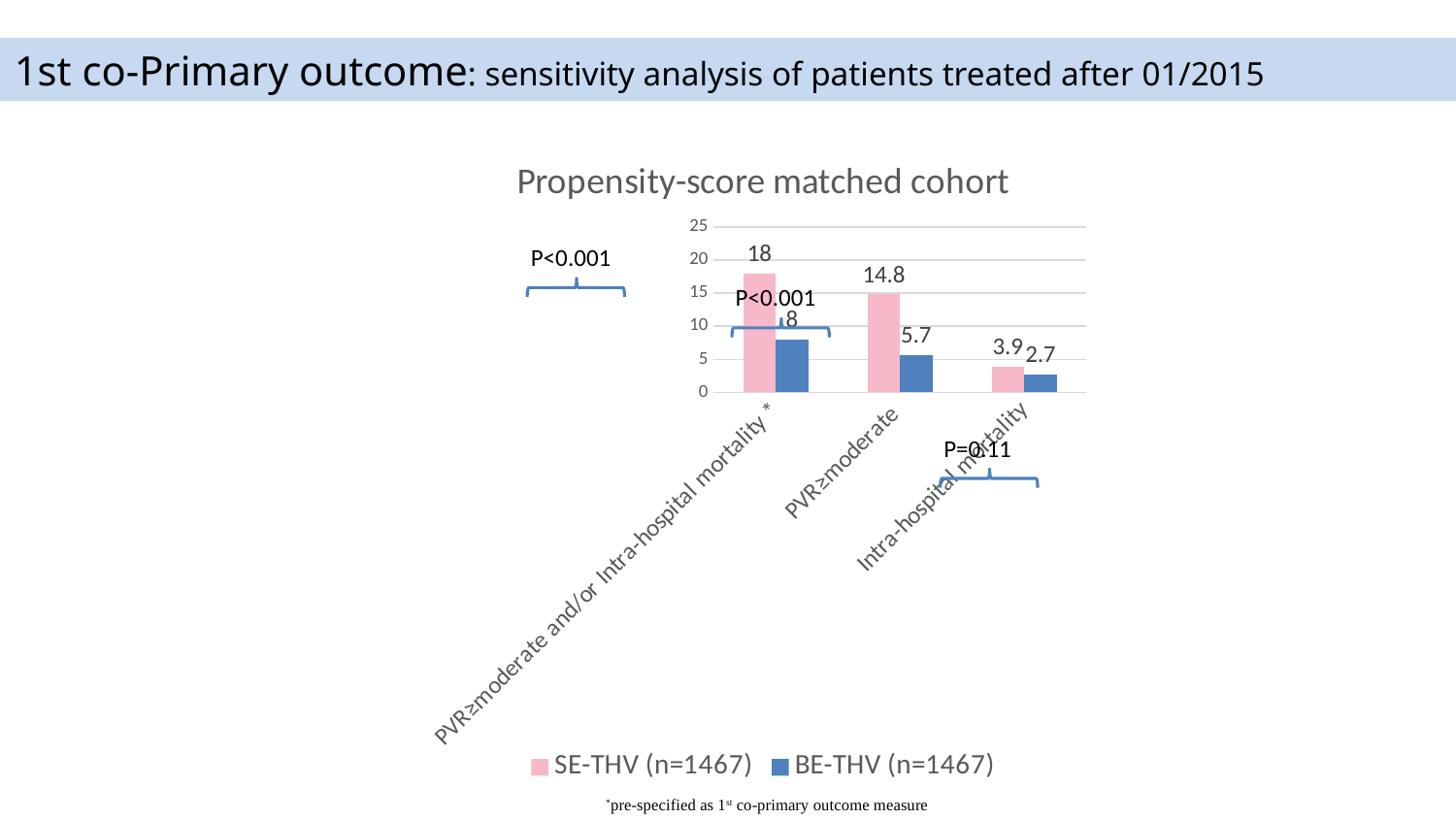
Which category has the highest SE-THV value? PVR≥moderate and/or Intra-hospital mortality How many series does the legend list? 2 What is the SE-THV value for PVR≥moderate and/or Intra-hospital mortality? 18 What is the BE-THV value for Intra-hospital mortality? 2.7 What is the BE-THV value for PVR≥moderate and/or Intra-hospital mortality? 8 Which category has the lowest BE-THV value? Intra-hospital mortality How many categories are shown on the x axis? 3 What is the title of the chart? Propensity-score matched cohort For Intra-hospital mortality, which series has the larger value, SE-THV or BE-THV? SE-THV What is the difference between the SE-THV and BE-THV values for PVR≥moderate? 9.1 What is the SE-THV value for PVR≥moderate? 14.8 What kind of chart is shown? bar chart